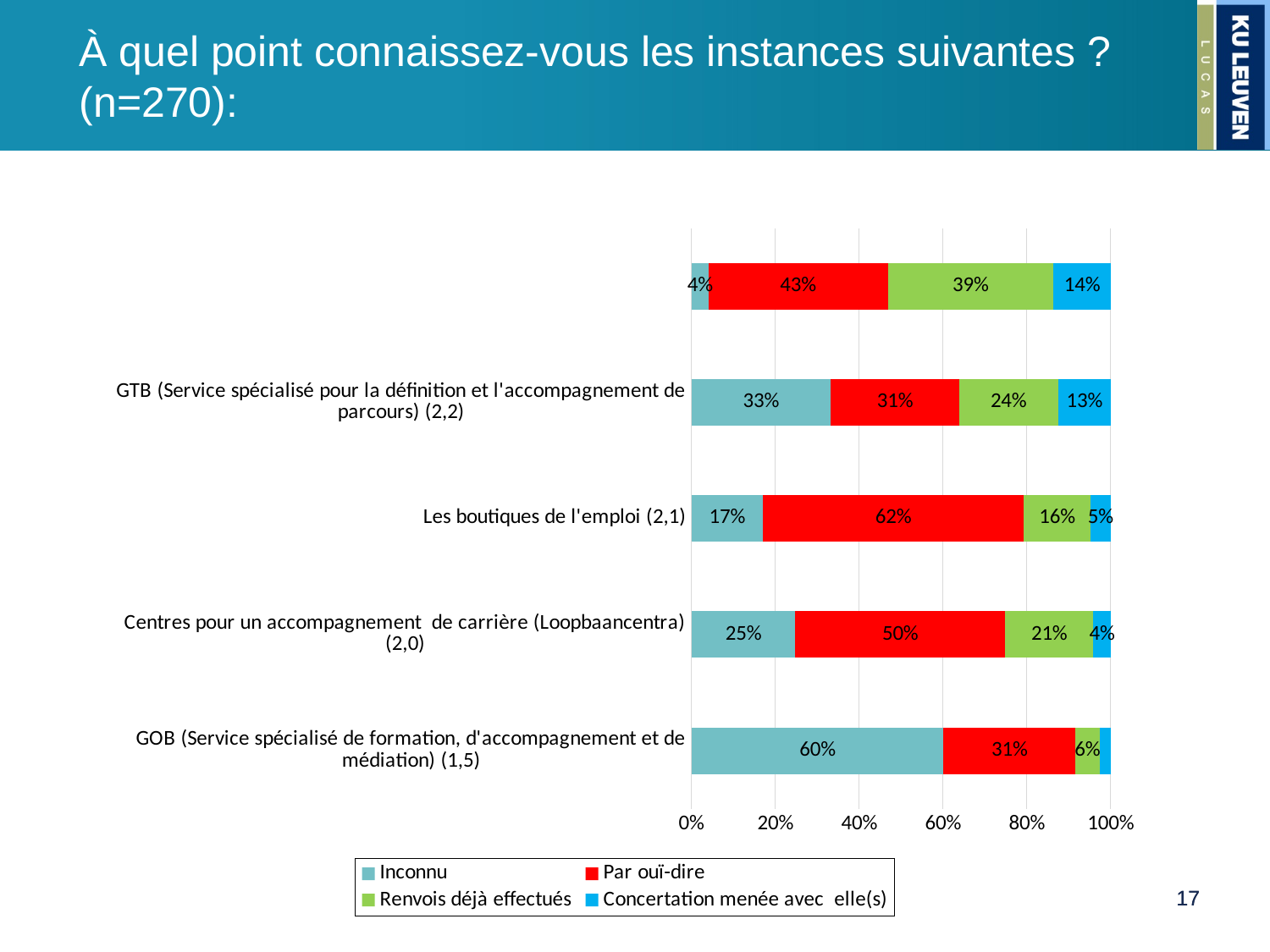
Which has a larger "Inconnu" share: GTB or Centres pour un accompagnement de carrière (Loopbaancentra)? GTB Which labelled instance has the highest "Par ouï-dire" share? Les boutiques de l'emploi What percentage of respondents answered "Inconnu" for GOB (Service spécialisé de formation, d'accompagnement et de médiation)? 60% How many series does the legend list? 4 What colour represents "Par ouï-dire" in the chart? Red For Centres pour un accompagnement de carrière (Loopbaancentra), how much larger is the "Par ouï-dire" share than the "Inconnu" share? 25 percentage points What is the "Renvois déjà effectués" value for GTB (Service spécialisé pour la définition et l'accompagnement de parcours)? 24% Which labelled instance has the highest "Inconnu" share? GOB (Service spécialisé de formation, d'accompagnement et de médiation) What is the "Par ouï-dire" value for Les boutiques de l'emploi? 62% How many bars are plotted in the chart? 5 What kind of chart is shown on the slide? Stacked bar chart What is the "Concertation menée avec elle(s)" value for Centres pour un accompagnement de carrière (Loopbaancentra)? 4%